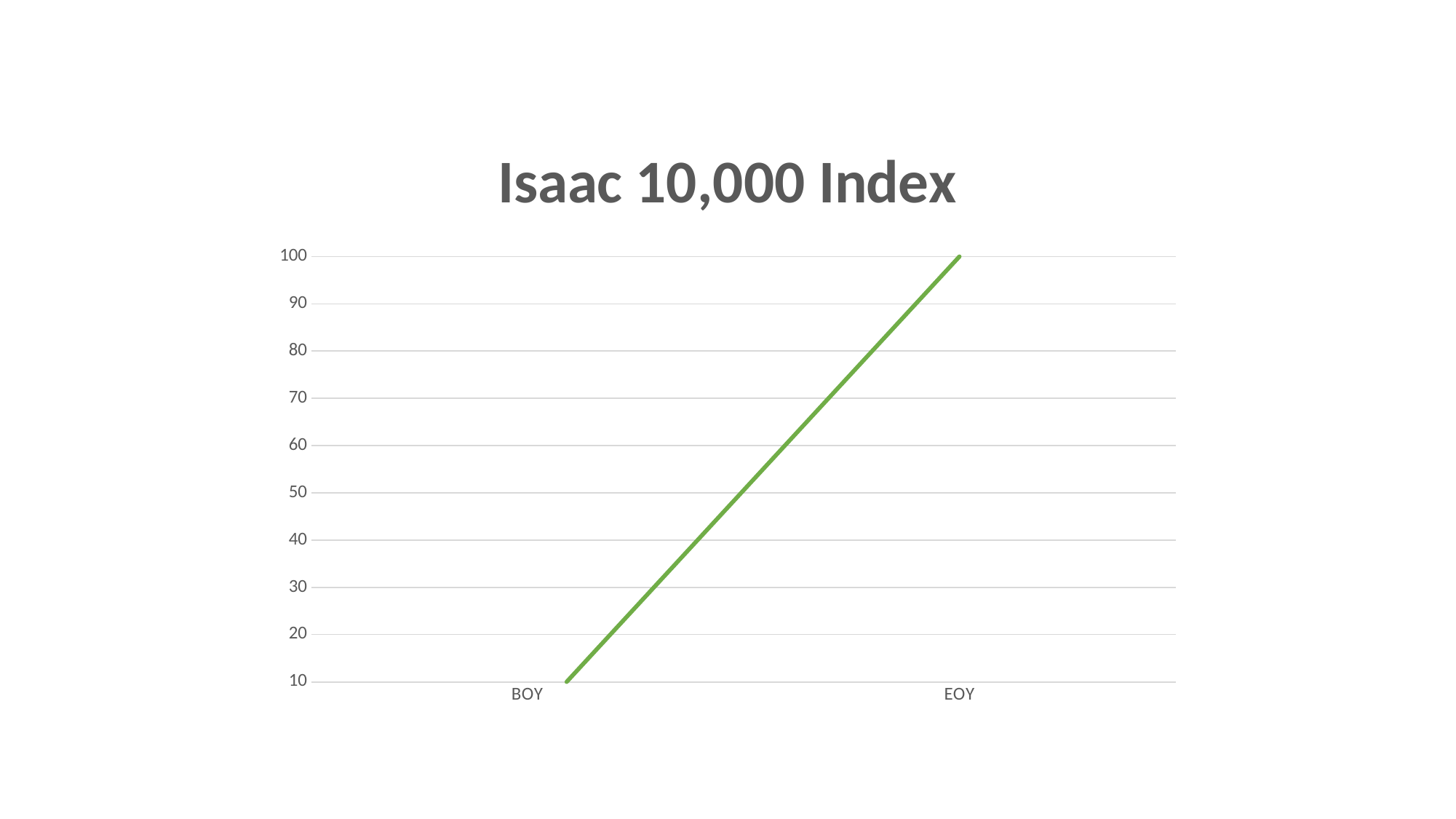
What is the value at EOY? 100 What is the title of the chart? Isaac 10,000 Index How many points are plotted on the line? 2 Which category has the lowest value? BOY Which category has the highest value? EOY What kind of chart is shown on the slide? line chart Which is larger, the value at BOY or the value at EOY? EOY Does the line rise or fall from BOY to EOY? rise Is the value at EOY greater or less than 50? greater What colour is the line in the chart? green